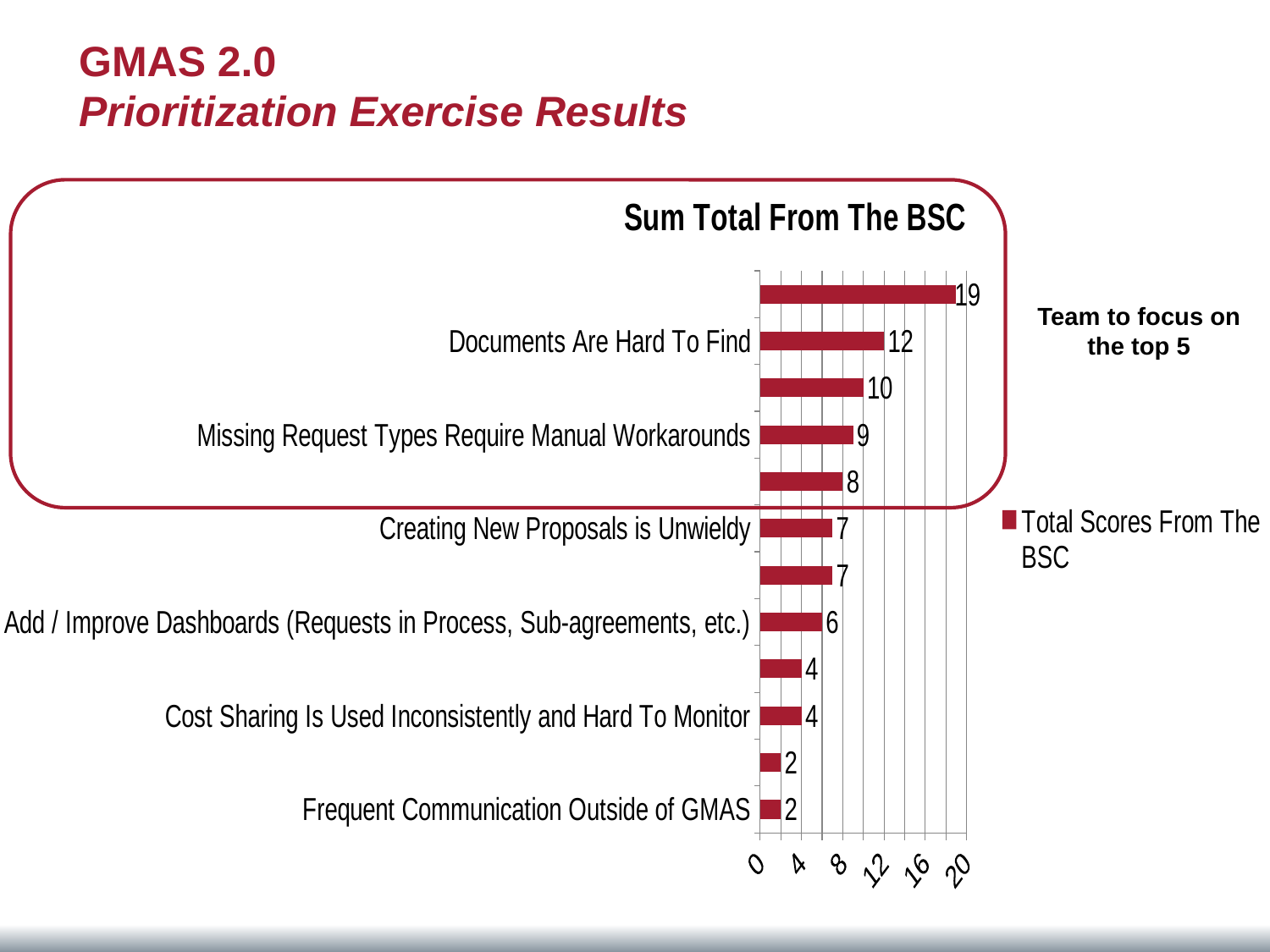
What is the value for Creating New Proposals is Unwieldy? 7 What is the difference between the values for Documents Are Hard To Find and Missing Request Types Require Manual Workarounds? 3 What is the value for Documents Are Hard To Find? 12 What is the value for Cost Sharing Is Used Inconsistently and Hard To Monitor? 4 What is the value for Missing Request Types Require Manual Workarounds? 9 What is the value for Add / Improve Dashboards (Requests in Process, Sub-agreements, etc.)? 6 What is the title of the chart? Sum Total From The BSC What kind of chart is shown on the slide? Bar chart What is the highest value shown on the chart? 19 Which has a larger value, Creating New Proposals is Unwieldy or Cost Sharing Is Used Inconsistently and Hard To Monitor? Creating New Proposals is Unwieldy What is the value for Frequent Communication Outside of GMAS? 2 How many bars are plotted on the chart? 12